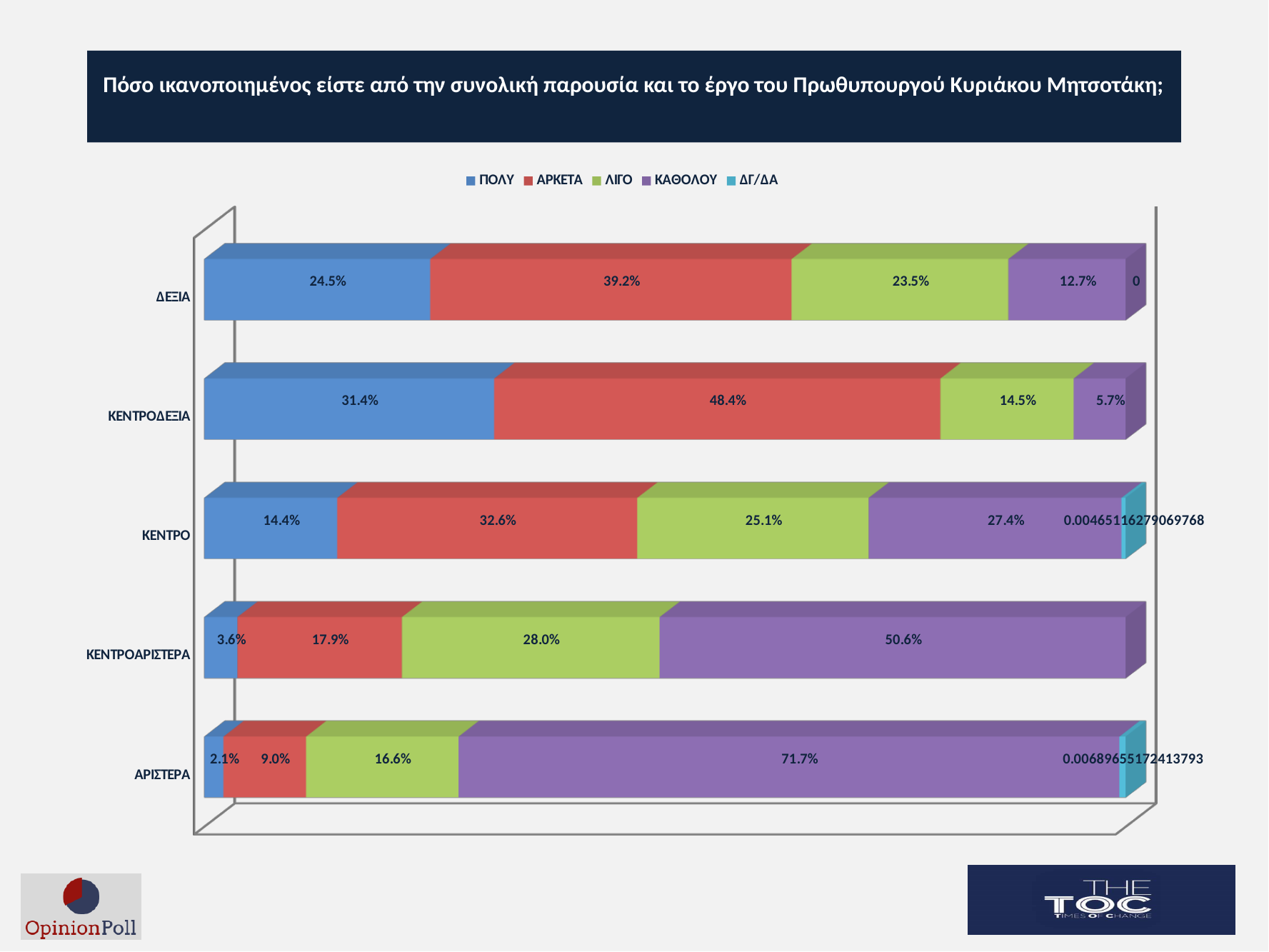
How many series does the legend list? 5 Which category has the lowest ΠΟΛΥ value? ΑΡΙΣΤΕΡΑ What is the ΑΡΚΕΤΑ value for ΔΕΞΙΑ? 39.2% How many categories are shown on the chart? 5 Which category has the highest ΑΡΚΕΤΑ value? ΚΕΝΤΡΟΔΕΞΙΑ Which category has the highest ΚΑΘΟΛΟΥ value? ΑΡΙΣΤΕΡΑ What kind of chart is shown on the slide? Stacked bar chart Which is larger: the ΛΙΓΟ value for ΔΕΞΙΑ or the ΛΙΓΟ value for ΚΕΝΤΡΟΑΡΙΣΤΕΡΑ? ΚΕΝΤΡΟΑΡΙΣΤΕΡΑ What is the ΠΟΛΥ value for ΚΕΝΤΡΟΔΕΞΙΑ? 31.4% What is the ΚΑΘΟΛΟΥ value for ΑΡΙΣΤΕΡΑ? 71.7% What is the ΛΙΓΟ value for ΚΕΝΤΡΟ? 25.1% What is the difference between the ΚΑΘΟΛΟΥ values for ΚΕΝΤΡΟΑΡΙΣΤΕΡΑ and ΚΕΝΤΡΟ? 23.2%